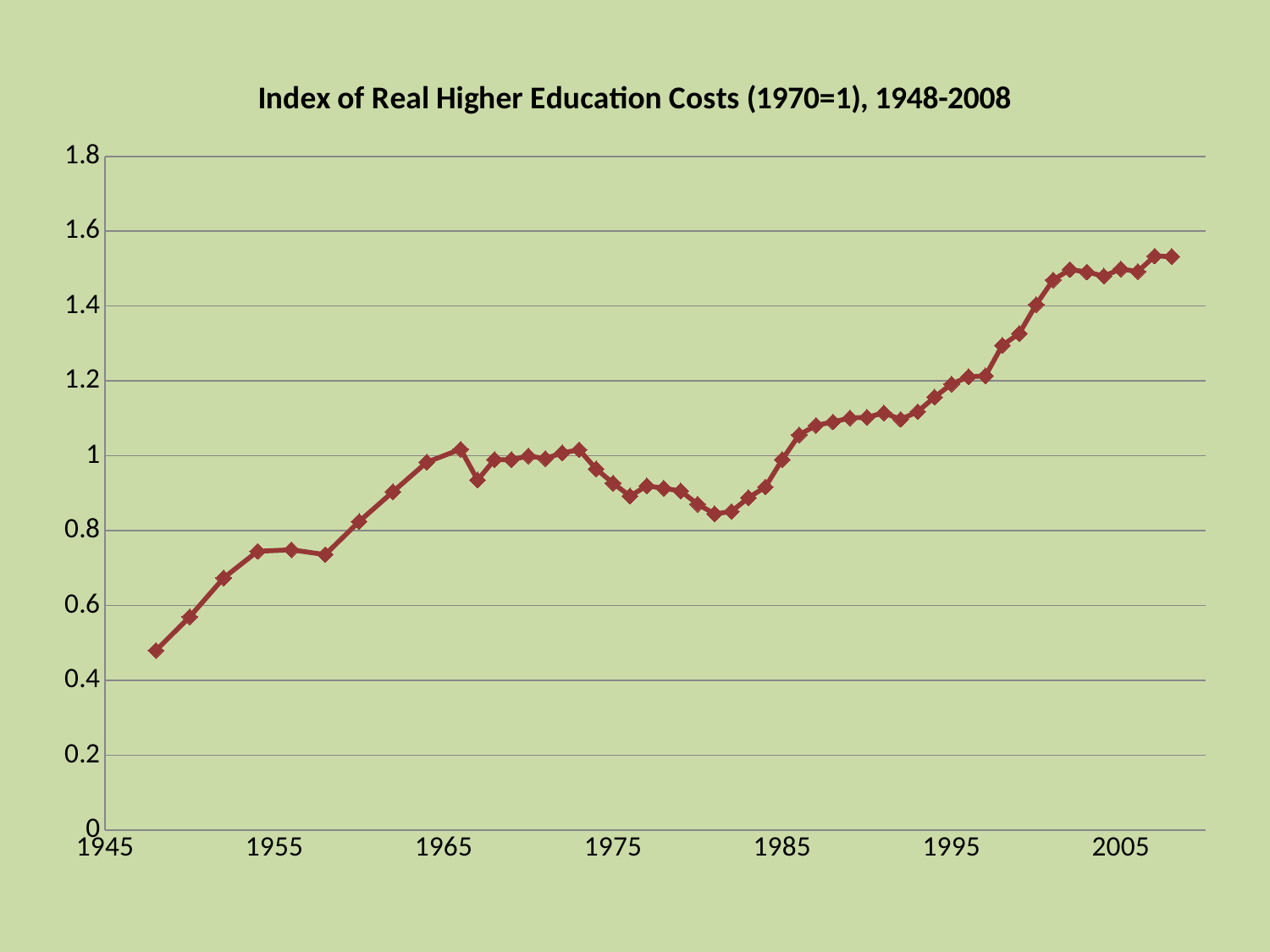
In which year is the index at its lowest value? 1948 Does the index generally rise or fall from 1948 to 2008? rise Is the value of the index in 1981 greater or less than 1? less Is the value of the index in 1948 greater or less than 0.6? less What is the value of the index in 1970? 1 Does the index rise or fall between 1973 and 1981? fall What kind of chart is shown on the slide? line chart What is the title of the chart? Index of Real Higher Education Costs (1970=1), 1948-2008 Is the value of the index in 2008 greater or less than 1.4? greater Which year has the larger index value, 1948 or 2008? 2008